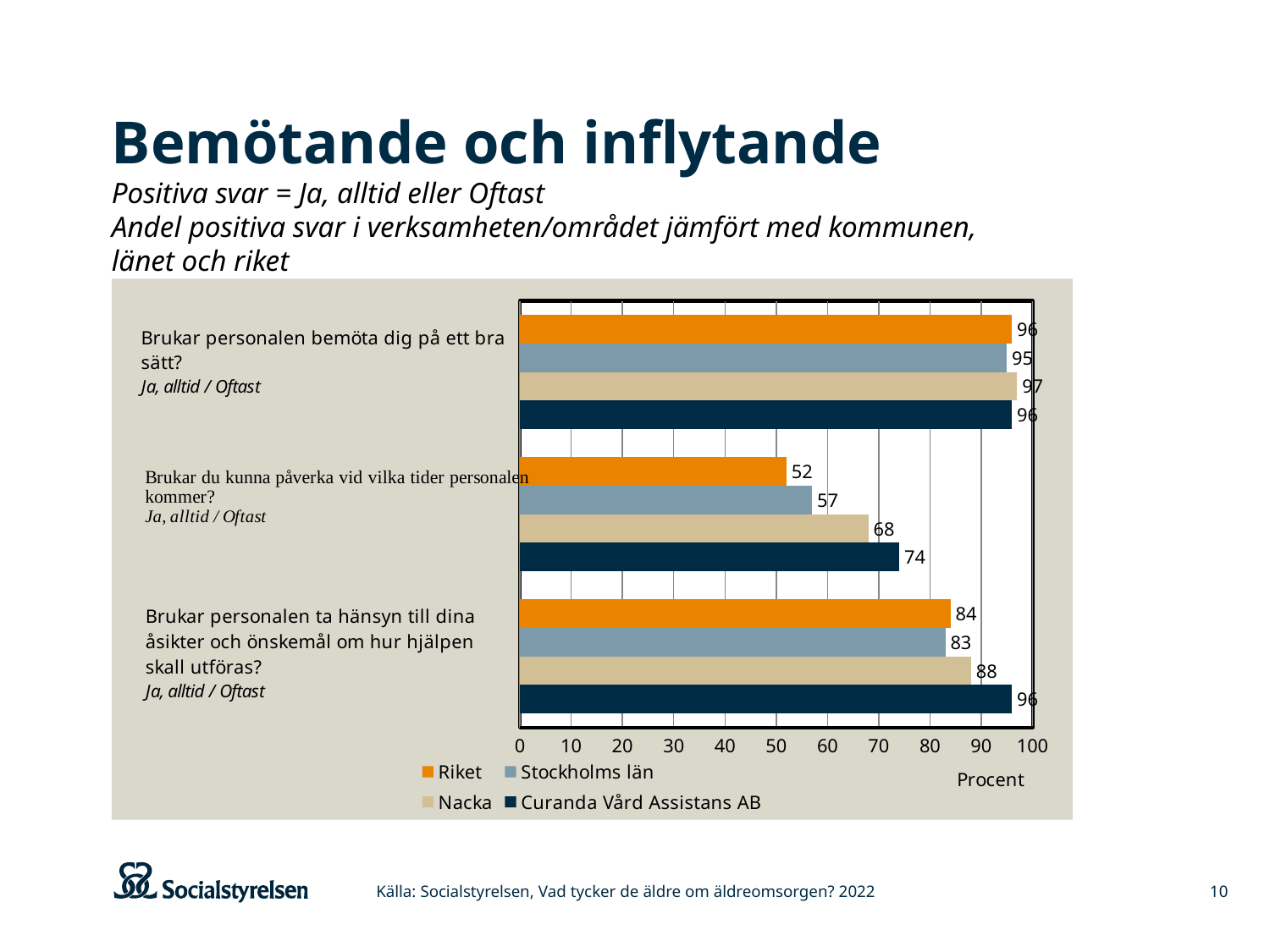
How many question categories are plotted on the chart? 3 What is the value for Stockholms län for the question "Brukar personalen bemöta dig på ett bra sätt?" 95 How many series does the legend list? 4 Which series has the highest value for the question "Brukar du kunna påverka vid vilka tider personalen kommer?" Curanda Vård Assistans AB What unit is shown on the x axis of the chart? Procent What kind of chart is shown on the slide? Bar chart What is the value for Nacka for the question "Brukar personalen ta hänsyn till dina åsikter och önskemål om hur hjälpen skall utföras?" 88 Which series has the lowest value for the question "Brukar du kunna påverka vid vilka tider personalen kommer?" Riket What is the value for Riket for the question "Brukar du kunna påverka vid vilka tider personalen kommer?" 52 What is the difference between Curanda Vård Assistans AB and Riket for the question "Brukar personalen ta hänsyn till dina åsikter och önskemål om hur hjälpen skall utföras?" 12 For the question "Brukar du kunna påverka vid vilka tider personalen kommer?", which is larger: Nacka or Stockholms län? Nacka What is the value for Curanda Vård Assistans AB for the question "Brukar du kunna påverka vid vilka tider personalen kommer?" 74